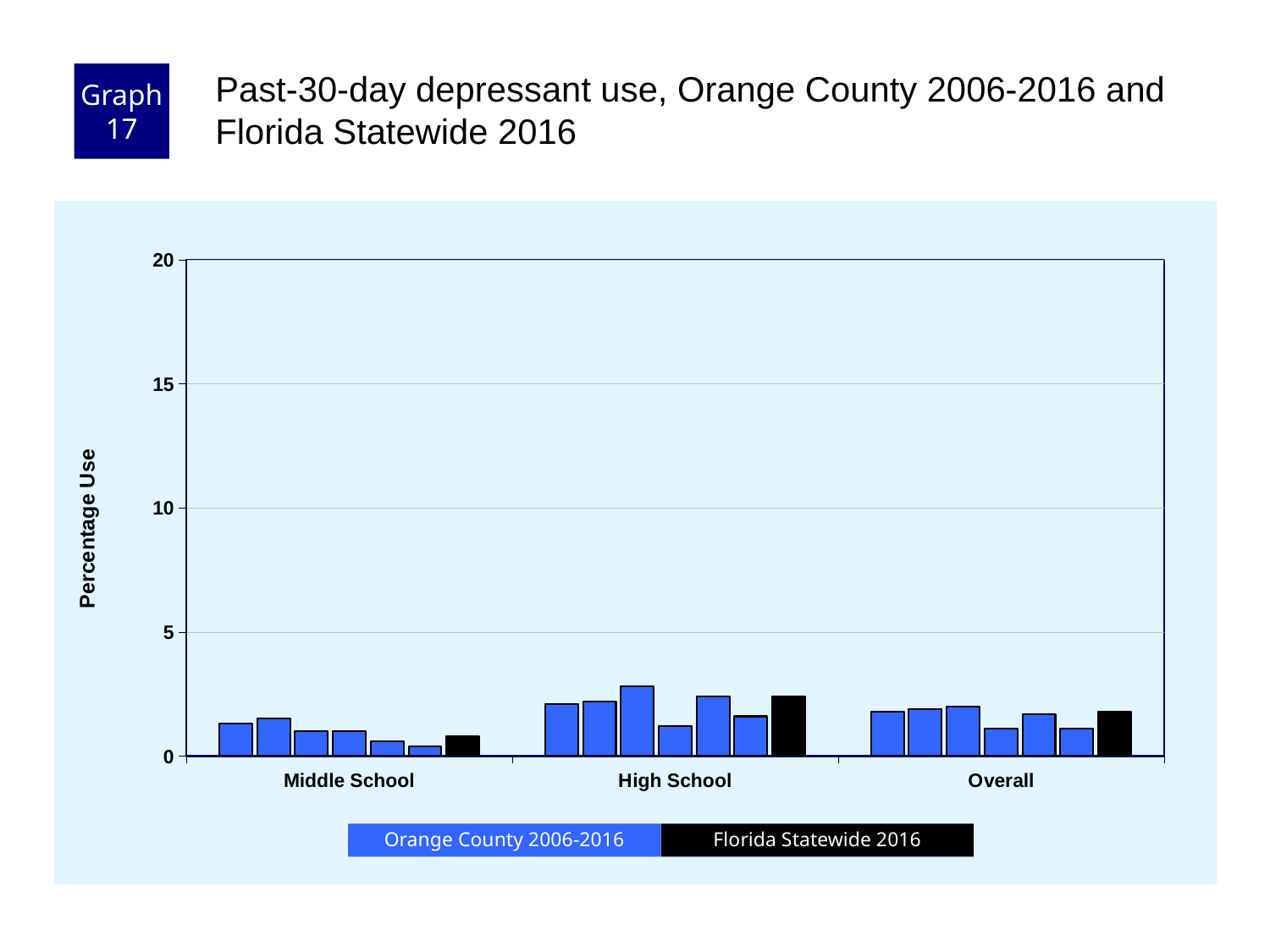
What kind of chart is shown on the slide? bar chart Which is larger, the Florida Statewide 2016 value for Overall or for Middle School? Overall How many bars are plotted in the Middle School group? 7 Which is larger, the Florida Statewide 2016 value for High School or for Middle School? High School What is the label on the y axis? Percentage Use Within the Middle School group, do the Orange County 2006-2016 bars generally rise or fall from left to right? fall Which category has the lowest Florida Statewide 2016 value? Middle School How many series does the legend list? 2 How many categories are shown on the x axis? 3 Is the Florida Statewide 2016 value for High School greater or less than 5? less Which series is shown in black in the legend? Florida Statewide 2016 Is the Florida Statewide 2016 value for Middle School greater or less than 5? less